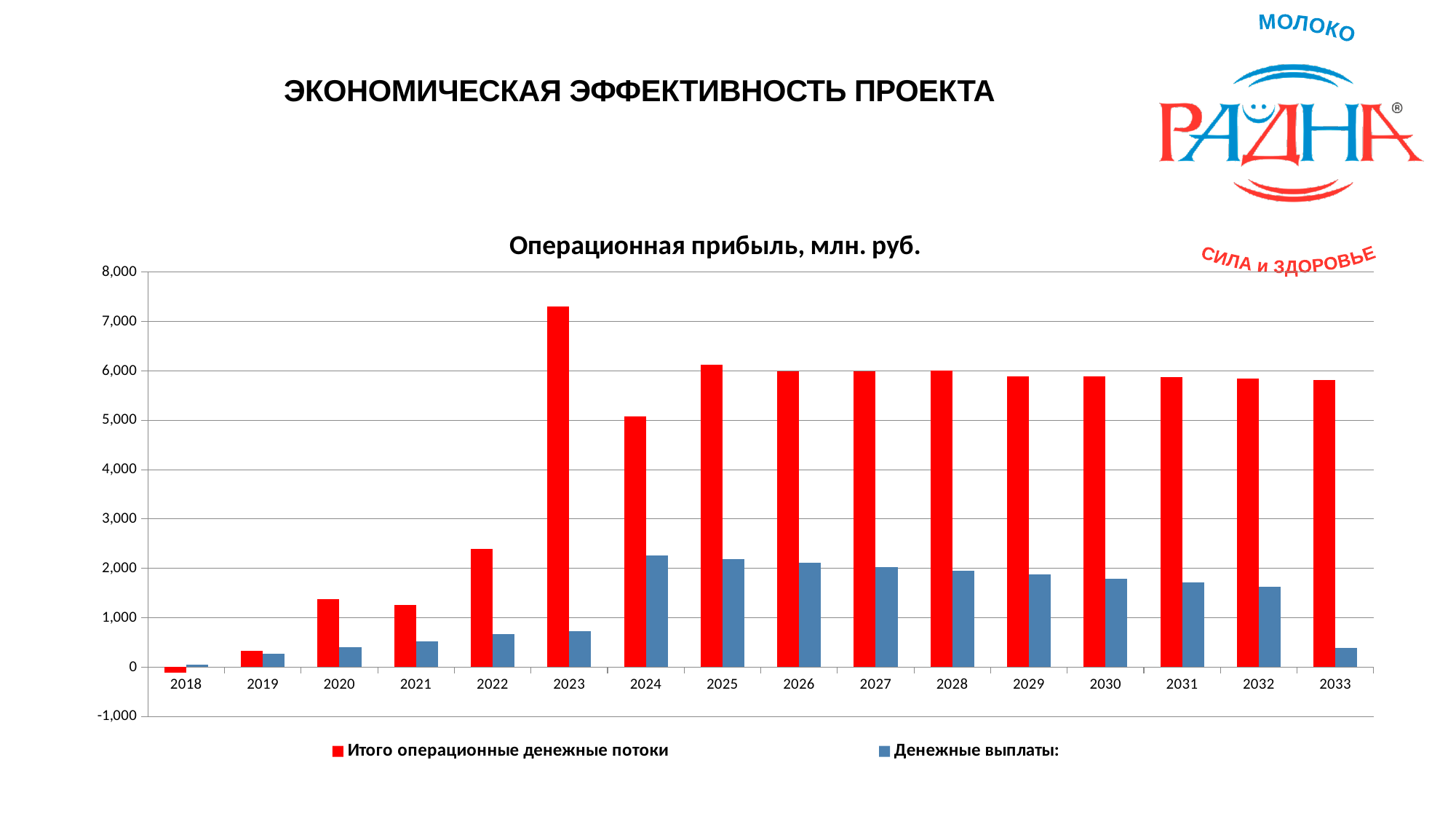
In which year is the value for Денежные выплаты highest? 2024 Is the value for Итого операционные денежные потоки in 2023 greater or less than 7,000? greater What kind of chart is shown on the slide? bar chart Is the value for Итого операционные денежные потоки in 2033 greater or less than 6,000? less Which is larger: Итого операционные денежные потоки in 2023 or in 2024? 2023 Is the value for Денежные выплаты in 2033 greater or less than 1,000? less How many series does the legend list? 2 In which year is the value for Итого операционные денежные потоки highest? 2023 In which year is the value for Итого операционные денежные потоки lowest? 2018 What is the title of the chart? Операционная прибыль, млн. руб. How many years are shown on the x axis? 16 Do the values for Денежные выплаты rise or fall from 2024 to 2032? fall